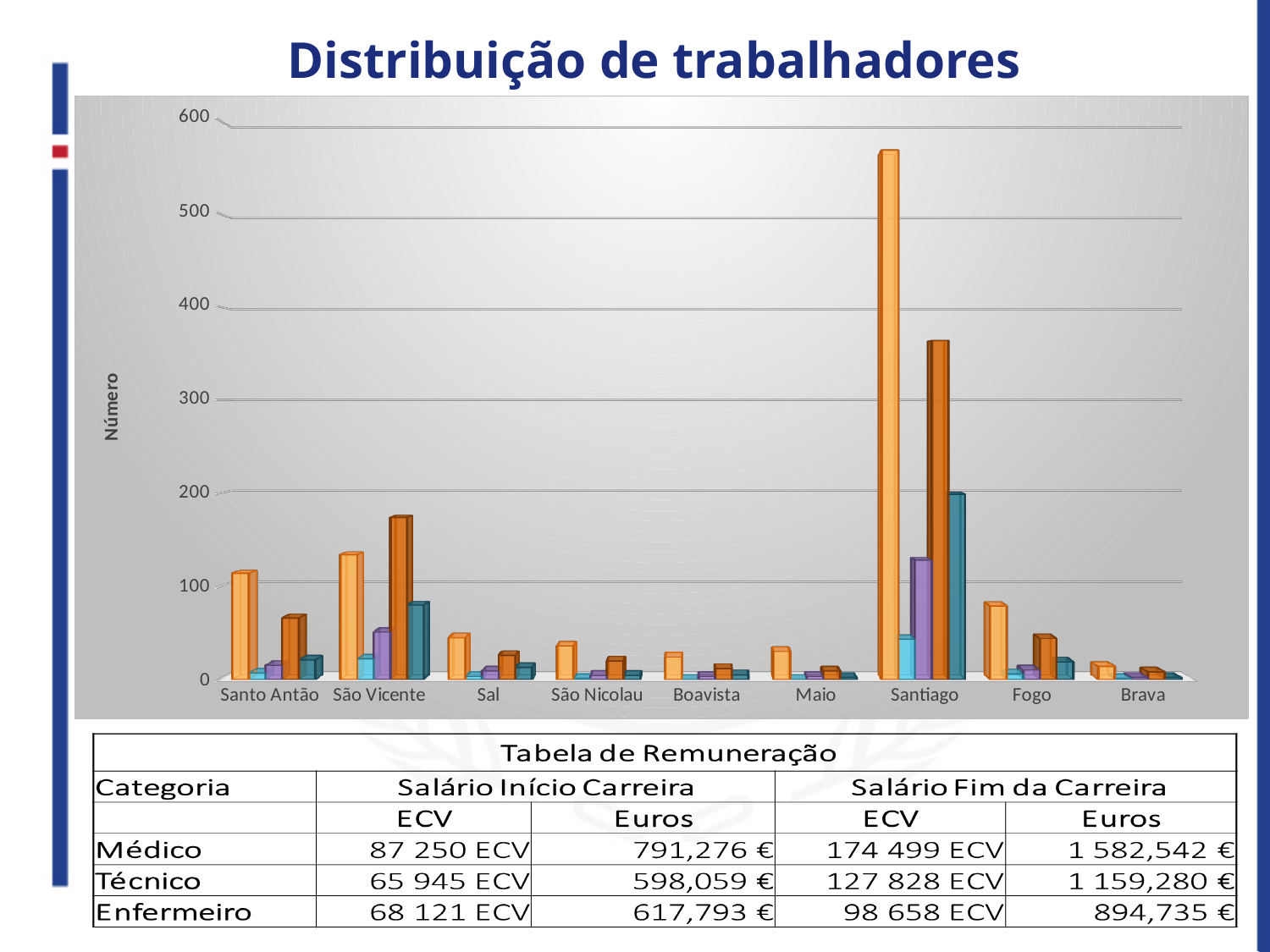
How many islands (categories) are shown on the x axis of the chart? 9 Is the tallest bar for São Vicente greater or less than 100? greater Which island has the tallest bar in the chart? Santiago Which island has the smallest bars overall in the chart? Brava Is the tallest bar for Fogo greater or less than 100? less What is the label on the vertical axis of the chart? Número Is the tallest bar for Santo Antão greater or less than 200? less Which has the taller first (leftmost) bar: Santo Antão or São Vicente? São Vicente What is the title of the chart? Distribuição de trabalhadores What kind of chart is shown on the slide? bar chart